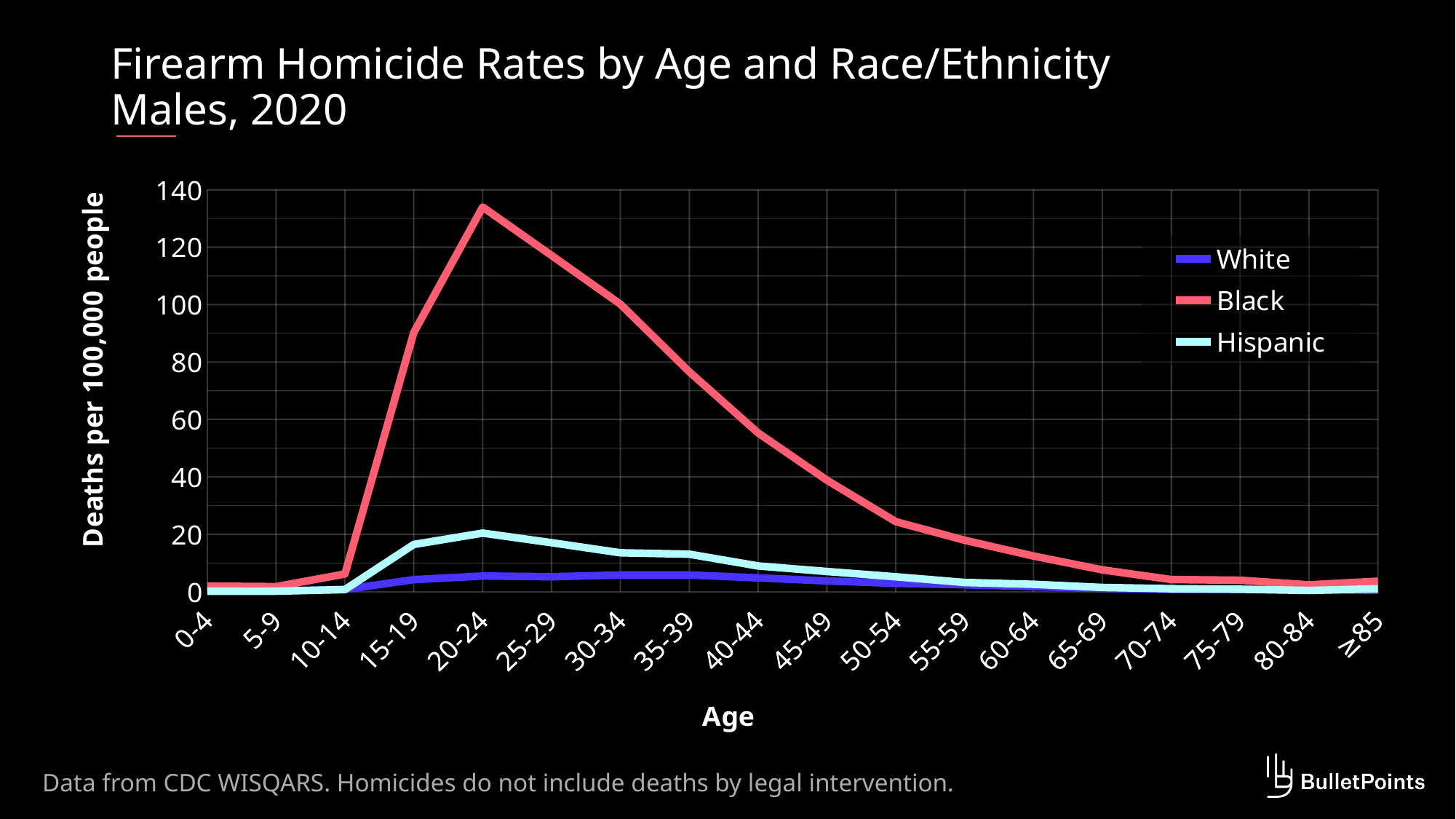
Is the value for Hispanic males aged 15-19 greater or less than 20? less Does the Black series rise or fall from the 20-24 age group to the ≥85 age group? Falls Is the value for Black males aged 15-19 greater or less than 80? greater What kind of chart is shown on the slide? Line chart At age 20-24, which series has the larger value, Hispanic or White? Hispanic How many age groups are shown along the x axis? 18 Which age group has the highest firearm homicide rate for Hispanic males? 20-24 Is the value for Black males aged 50-54 greater or less than 20? greater At age 20-24, which series has the larger value, Black or Hispanic? Black Which age group has the highest firearm homicide rate for Black males? 20-24 How many series does the legend list? 3